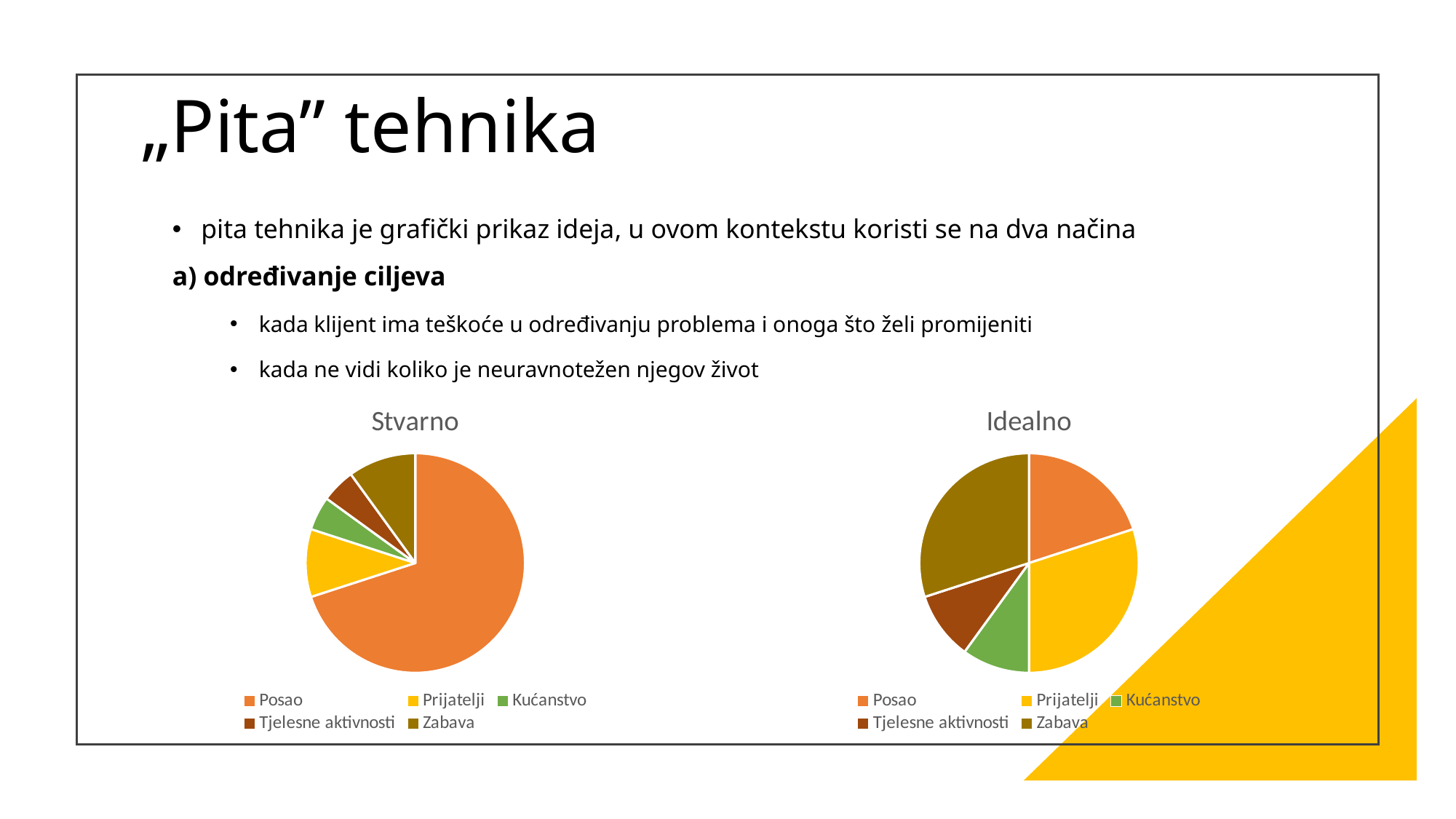
In the "Stvarno" chart, which slice is larger, Zabava or Tjelesne aktivnosti? Zabava In the "Idealno" chart, which slice is larger, Prijatelji or Posao? Prijatelji What kind of chart is the "Stvarno" chart? pie chart How many categories does the legend of the "Stvarno" chart list? 5 In the "Stvarno" chart, which slice is larger, Prijatelji or Kućanstvo? Prijatelji In the "Stvarno" chart, which colour represents Prijatelji? yellow In the "Stvarno" chart, which category has the largest slice? Posao How many categories does the legend of the "Idealno" chart list? 5 What kind of chart is the "Idealno" chart? pie chart What are the titles of the two charts on the slide? Stvarno and Idealno